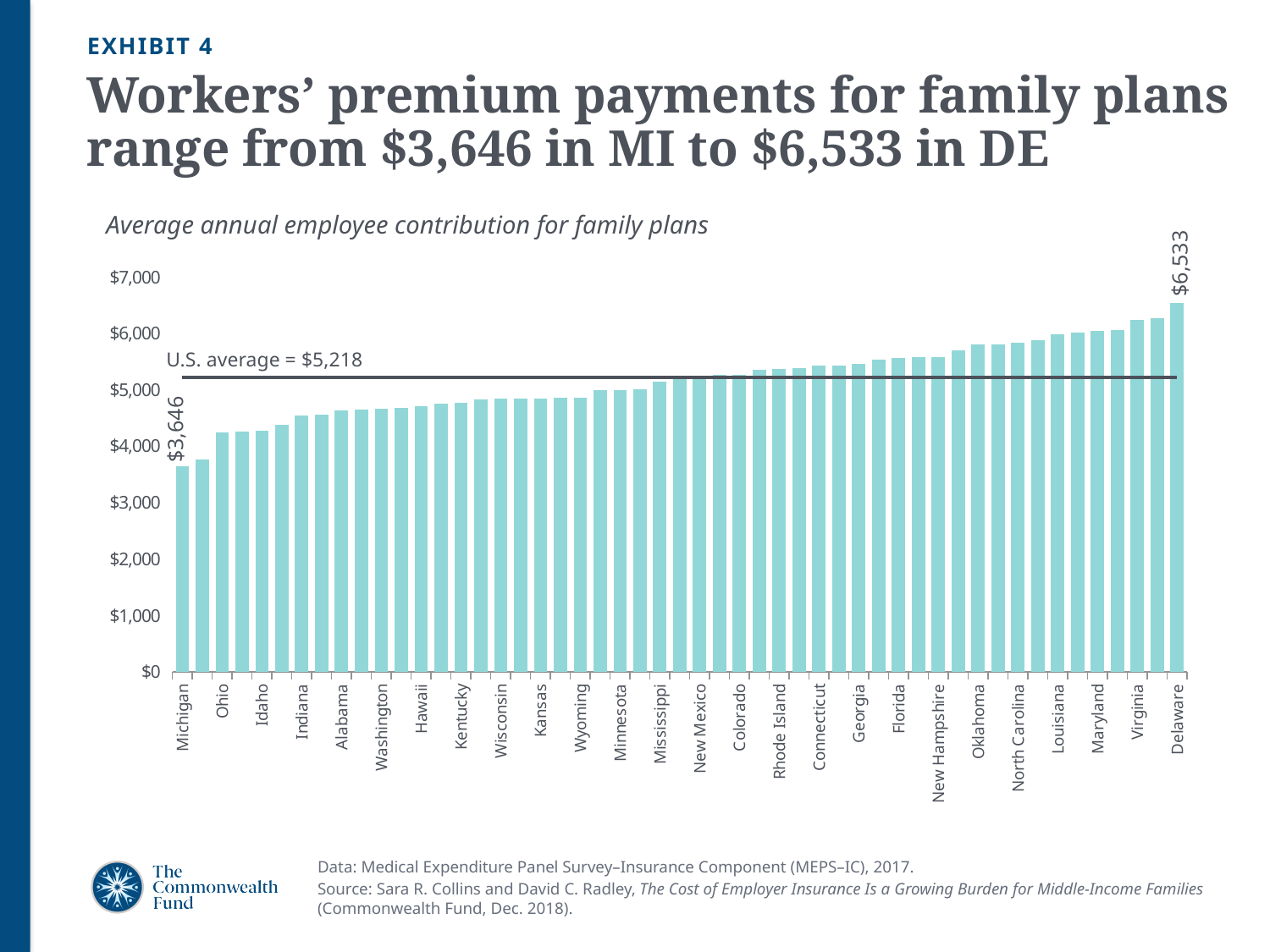
What is the average annual employee contribution for family plans in Delaware? $6,533 What does the horizontal line across the bars represent? U.S. average = $5,218 Is the value for Ohio greater or less than $4,000? greater Is the value for Virginia greater or less than $5,000? greater Which state has the highest average annual employee contribution for family plans? Delaware What is the U.S. average employee contribution for family plans shown on the chart? $5,218 Which state has the lowest average annual employee contribution for family plans? Michigan What is the average annual employee contribution for family plans in Michigan? $3,646 Do the bar values rise or fall moving from left to right across the chart? Rise Which state has the larger employee contribution for family plans, Ohio or Maryland? Maryland How much higher is Delaware's employee contribution than Michigan's? $2,887 What kind of chart is shown on the slide? Bar chart